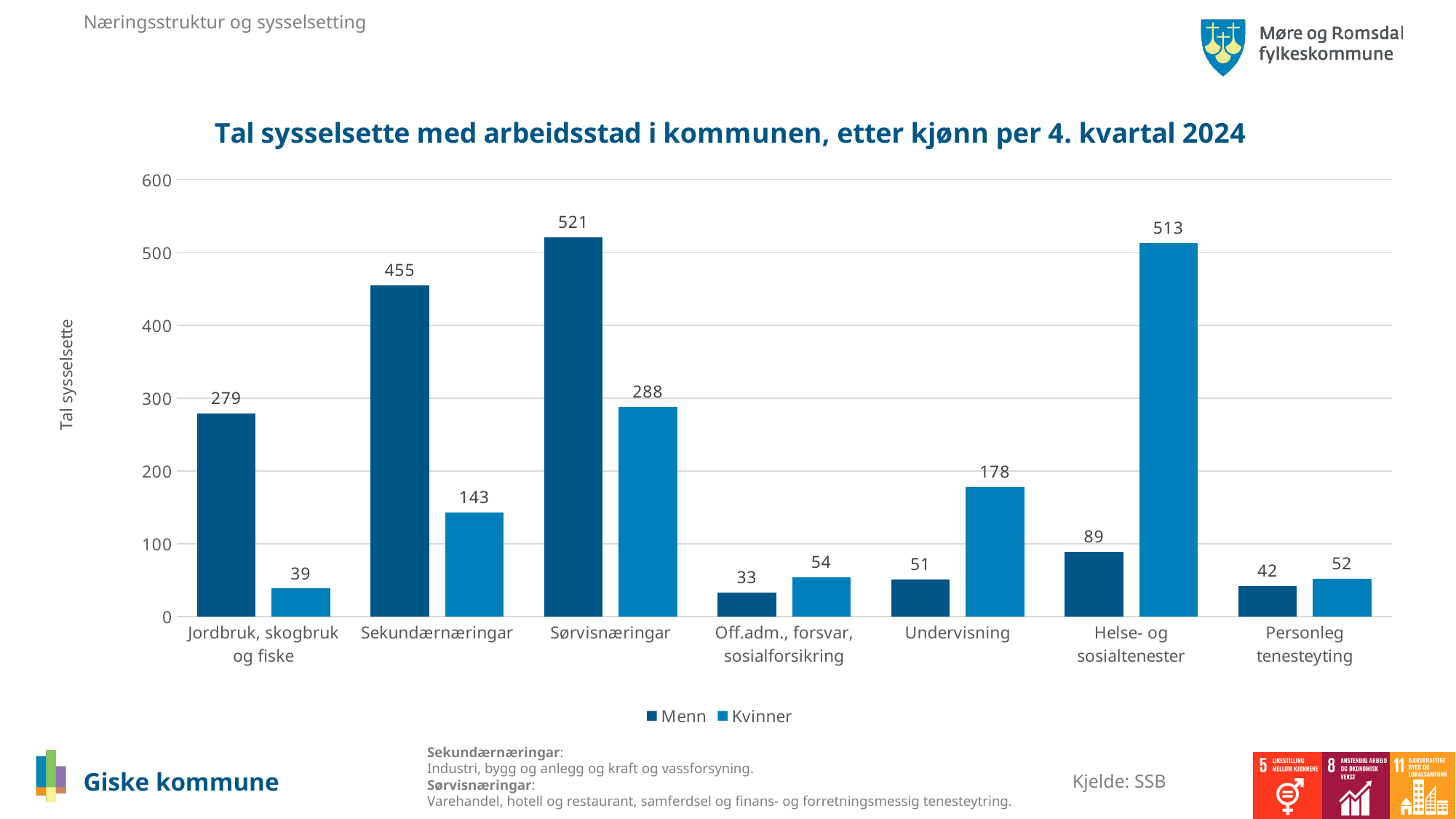
What is the value for Kvinner in Helse- og sosialtenester? 513 What is the total of Menn and Kvinner in Personleg tenesteyting? 94 How many series does the legend list? 2 What is the title of the chart? Tal sysselsette med arbeidsstad i kommunen, etter kjønn per 4. kvartal 2024 What is the difference between Menn and Kvinner in Sekundærnæringar? 312 What is the value for Menn in Sørvisnæringar? 521 How many categories are shown on the x axis? 7 What kind of chart is shown on the slide? Bar chart Which category has the highest value for Menn? Sørvisnæringar What is the value for Kvinner in Jordbruk, skogbruk og fiske? 39 Which category has the lowest value for Kvinner? Jordbruk, skogbruk og fiske Which is larger in Undervisning, Menn or Kvinner? Kvinner